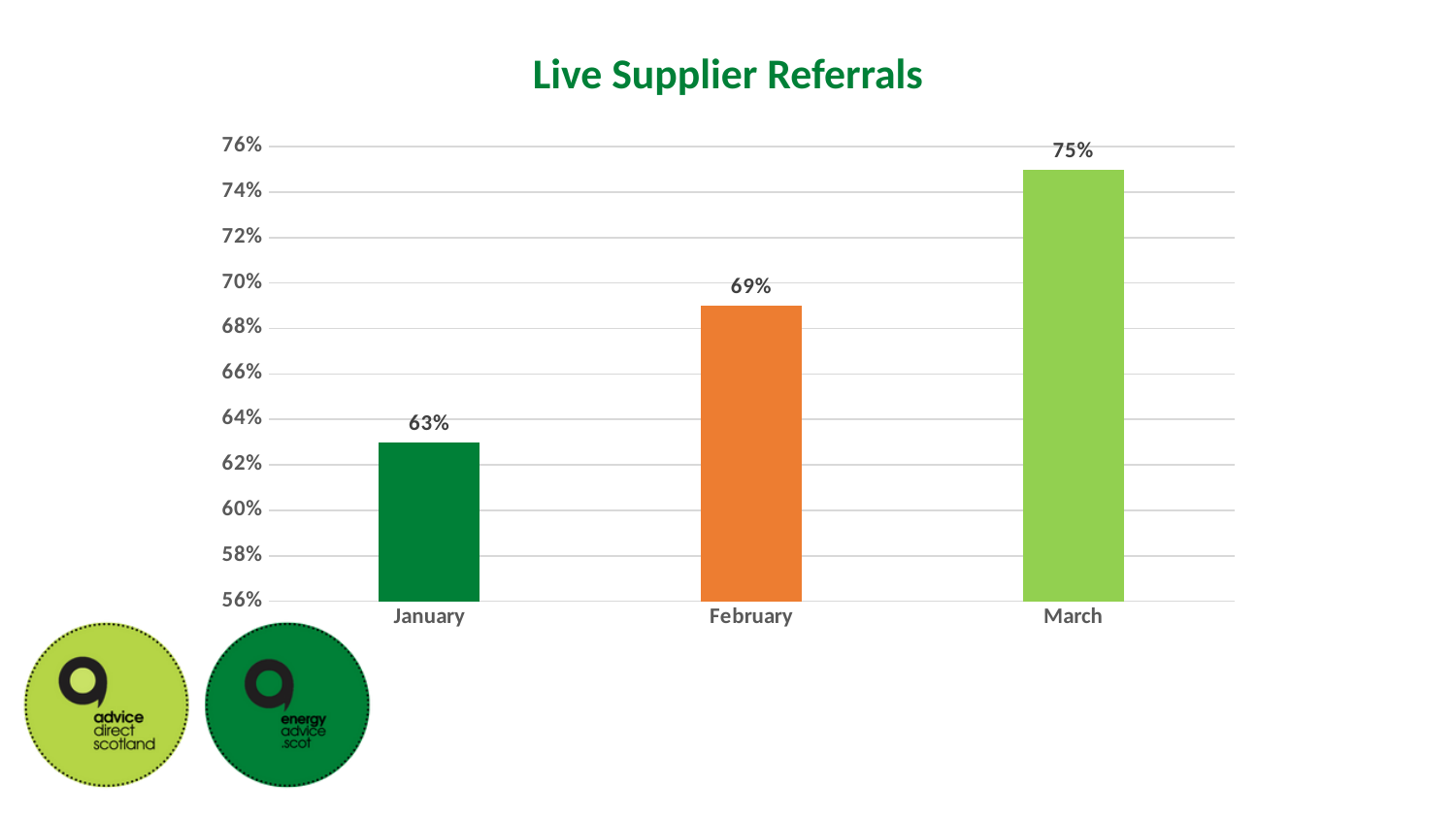
How many months are shown on the chart? 3 What is the value for February? 69% What is the value for January? 63% Is the value for February greater or less than 70%? less What is the value for March? 75% What is the difference between the values for February and January? 6% What is the difference between the values for March and January? 12% Which month has the highest value? March What kind of chart is shown on the slide? bar chart Do the values rise or fall from January to March? rise Which is larger, the value for February or the value for March? March Which month has the lowest value? January